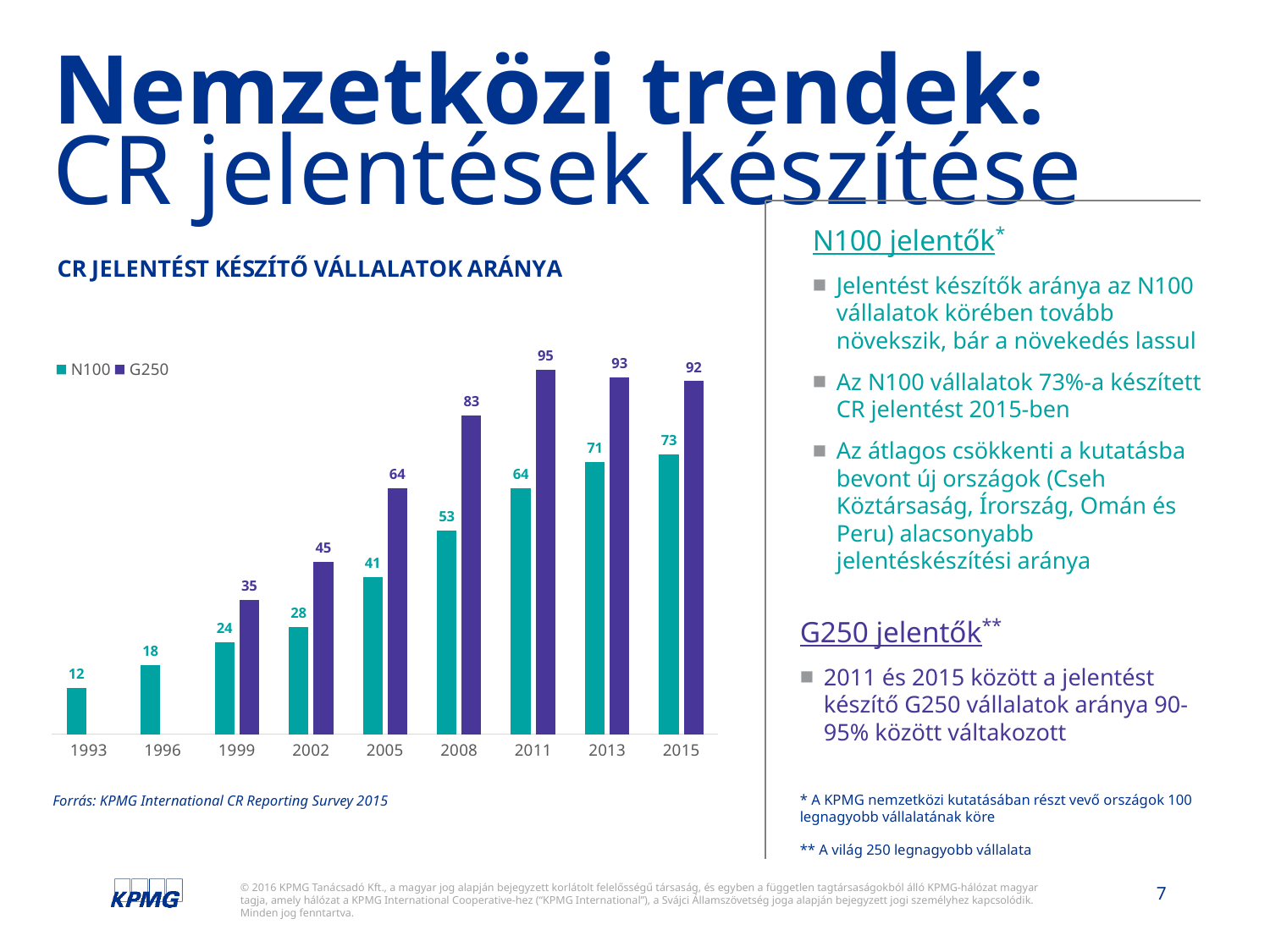
What is the title of the chart? CR JELENTÉST KÉSZÍTŐ VÁLLALATOK ARÁNYA Which is larger in 2005, the N100 value or the G250 value? G250 What is the G250 value for 2011? 95 What kind of chart is shown on the slide? Bar chart What is the N100 value for 1993? 12 What is the difference between the G250 and N100 values in 2008? 30 Do the N100 values rise or fall from 1993 to 2015? Rise Which year has the lowest N100 value? 1993 How many series does the legend list? 2 How many years are shown on the x axis? 9 What is the N100 value for 2015? 73 Which year has the highest G250 value? 2011